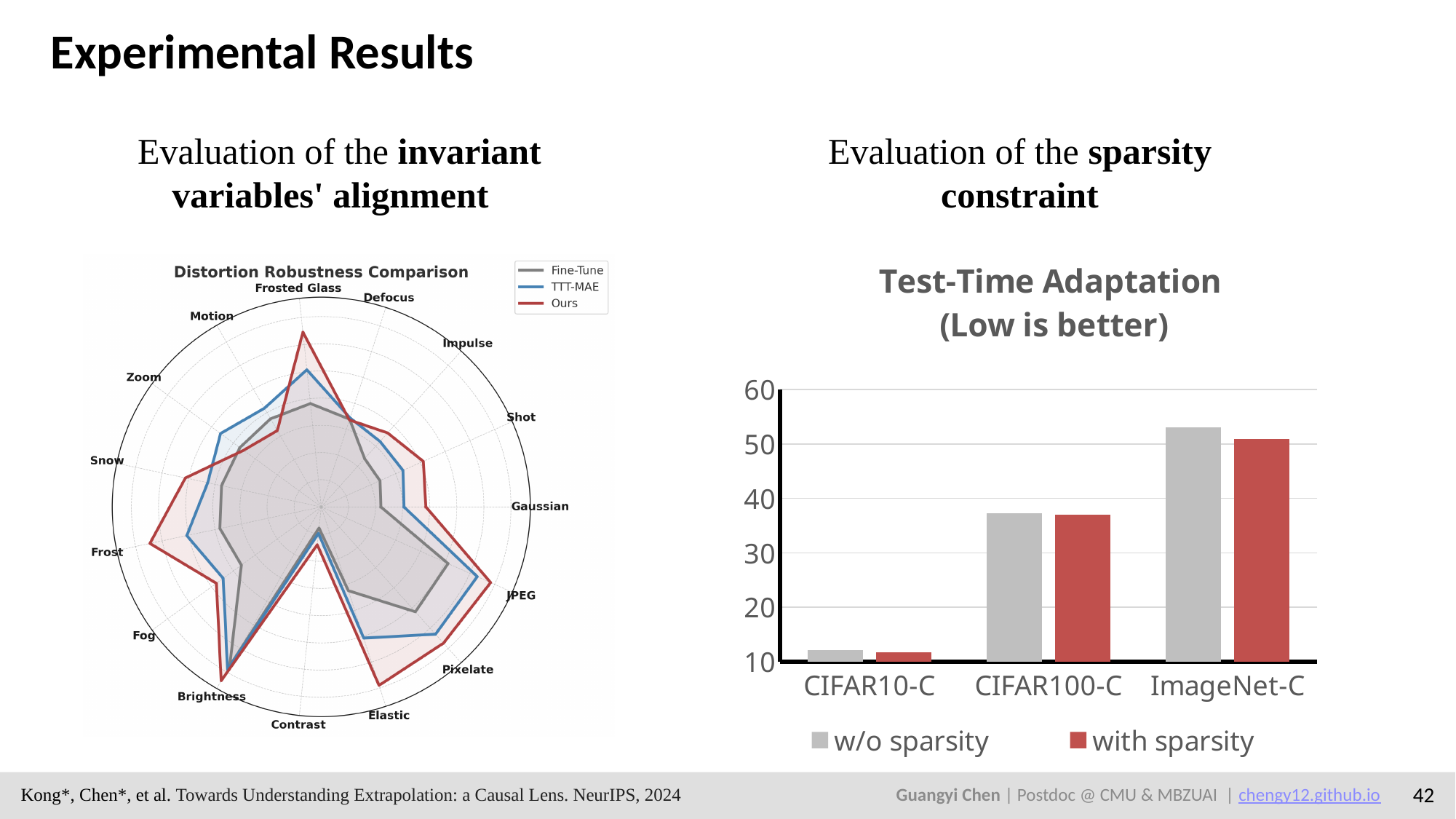
In the 'Test-Time Adaptation' bar chart, is the 'w/o sparsity' value for ImageNet-C greater or less than 50? greater In the 'Test-Time Adaptation' bar chart, which category has the lowest values? CIFAR10-C In the 'Test-Time Adaptation' bar chart, how many series does the legend list? 2 In the 'Distortion Robustness Comparison' radar chart, how many series does the legend list? 3 In the 'Test-Time Adaptation' bar chart, is the 'with sparsity' value for CIFAR100-C greater or less than 40? less In the 'Distortion Robustness Comparison' radar chart, which colour is used for the 'Ours' series? red In the 'Test-Time Adaptation' bar chart, is the 'w/o sparsity' value for CIFAR10-C greater or less than 20? less What kind of chart is the chart on the right titled 'Test-Time Adaptation (Low is better)'? bar chart In the 'Test-Time Adaptation' bar chart, which category has the highest values? ImageNet-C In the 'Test-Time Adaptation' bar chart, for ImageNet-C, which is larger: the 'w/o sparsity' bar or the 'with sparsity' bar? w/o sparsity In the 'Test-Time Adaptation' bar chart, how many categories are shown on the x axis? 3 What kind of chart is the 'Distortion Robustness Comparison' chart on the left? radar chart